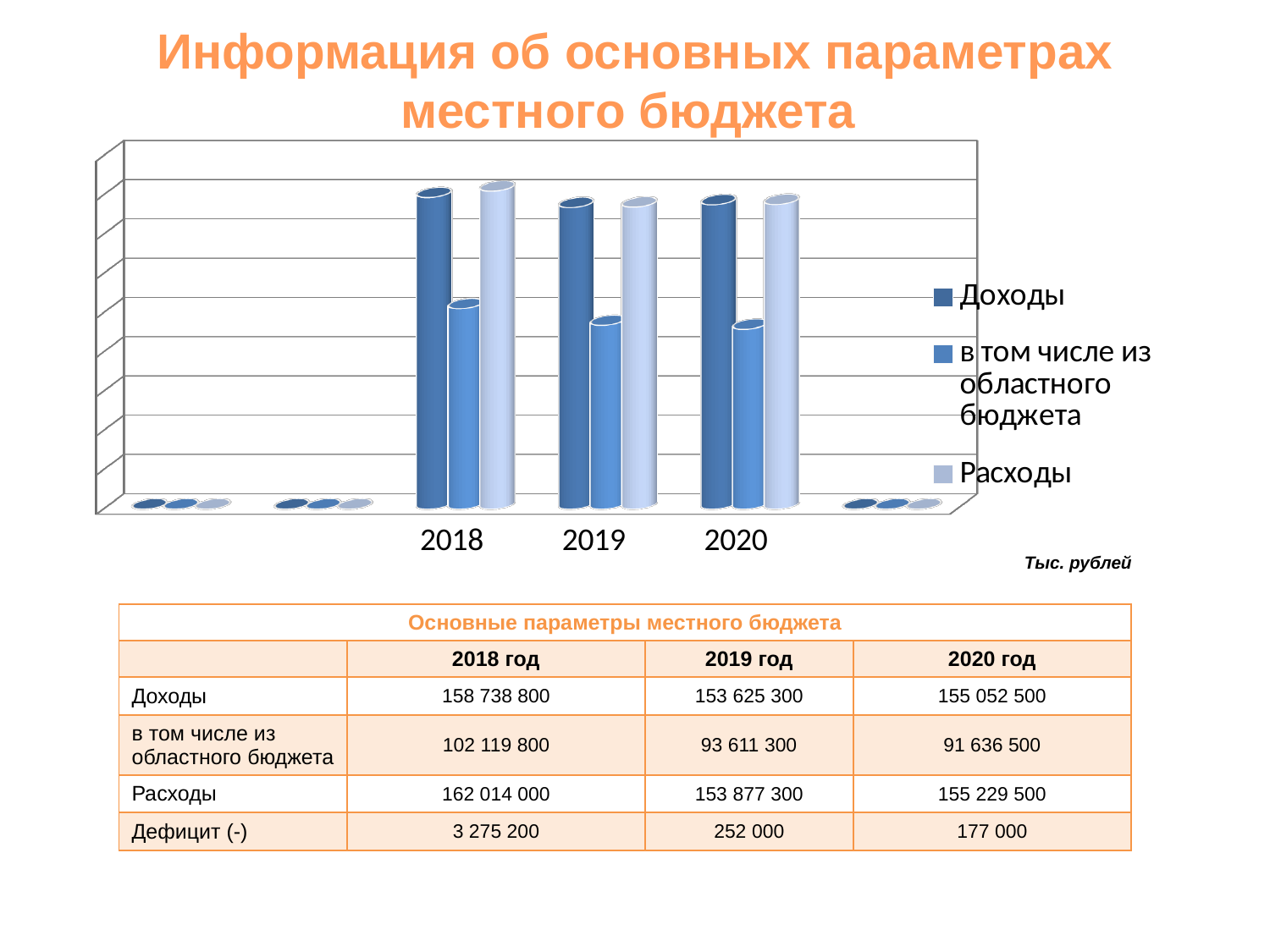
In which year is 'в том числе из областного бюджета' the lowest? 2020 In 2018, which is larger: Доходы or Расходы? Расходы What is the value of 'в том числе из областного бюджета' for 2019? 93 611 300 What is the value of Доходы for 2018? 158 738 800 What kind of chart is shown on the slide? bar chart What is the value of Расходы for 2020? 155 229 500 In which year is Доходы the highest? 2018 How many series does the chart legend list? 3 Which series is shown in the lightest blue colour in the chart? Расходы How many years are labeled on the x axis of the chart? 3 What is the difference between Расходы and Доходы in 2018? 3 275 200 Do the values for 'в том числе из областного бюджета' rise or fall from 2018 to 2020? fall